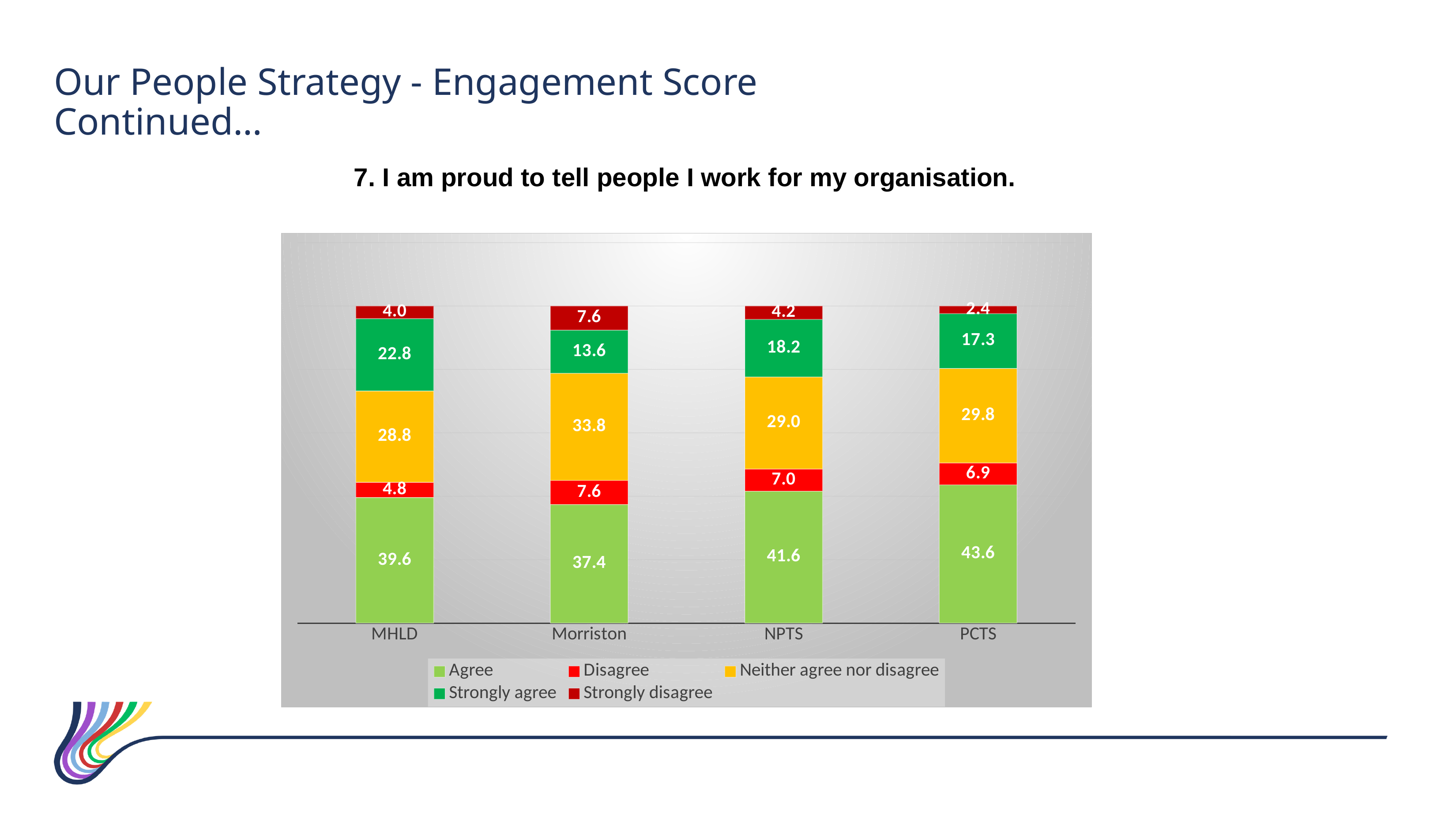
Which is larger, the Neither agree nor disagree value for Morriston or for MHLD? Morriston Which category has the highest Agree value? PCTS How many categories are shown on the x axis? 4 Which category has the highest Strongly agree value? MHLD What is the Strongly agree value for Morriston? 13.6 What is the Neither agree nor disagree value for NPTS? 29.0 Which category has the lowest Strongly disagree value? PCTS What kind of chart is shown on the slide? Stacked bar chart What is the Strongly disagree value for MHLD? 4.0 How many series does the legend list? 5 What is the Agree value for PCTS? 43.6 What is the difference between the Agree values for PCTS and Morriston? 6.2